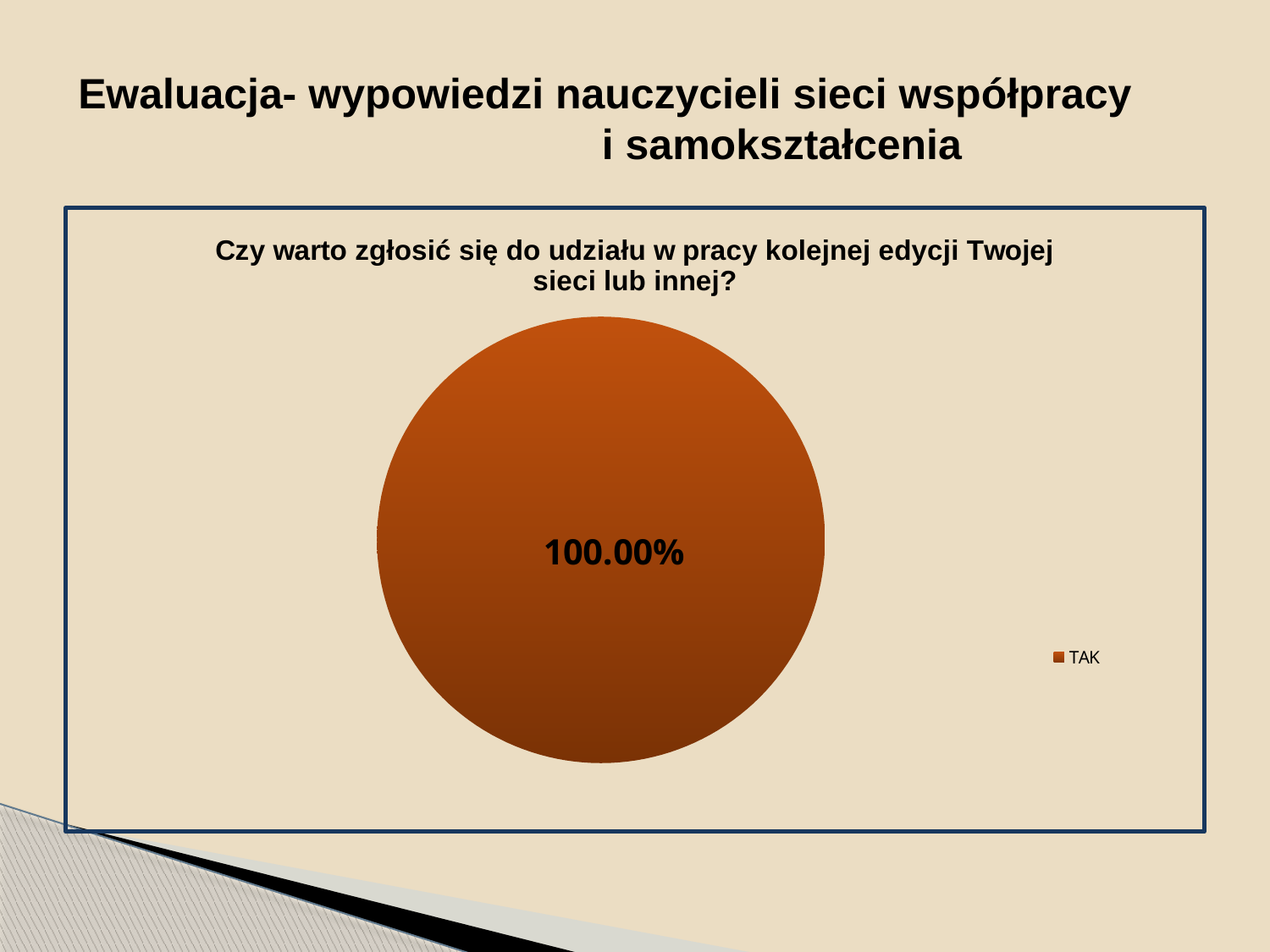
What is the label of the only legend entry in the chart? TAK How many entries does the legend list? 1 What kind of chart is shown on the slide? pie chart Is the value for TAK greater or less than 50%? greater What is the title of the chart? Czy warto zgłosić się do udziału w pracy kolejnej edycji Twojej sieci lub innej? How many slices does the pie chart have? 1 What is the value shown for TAK in the pie chart? 100.00% What share of the pie does the TAK slice take? 100.00%